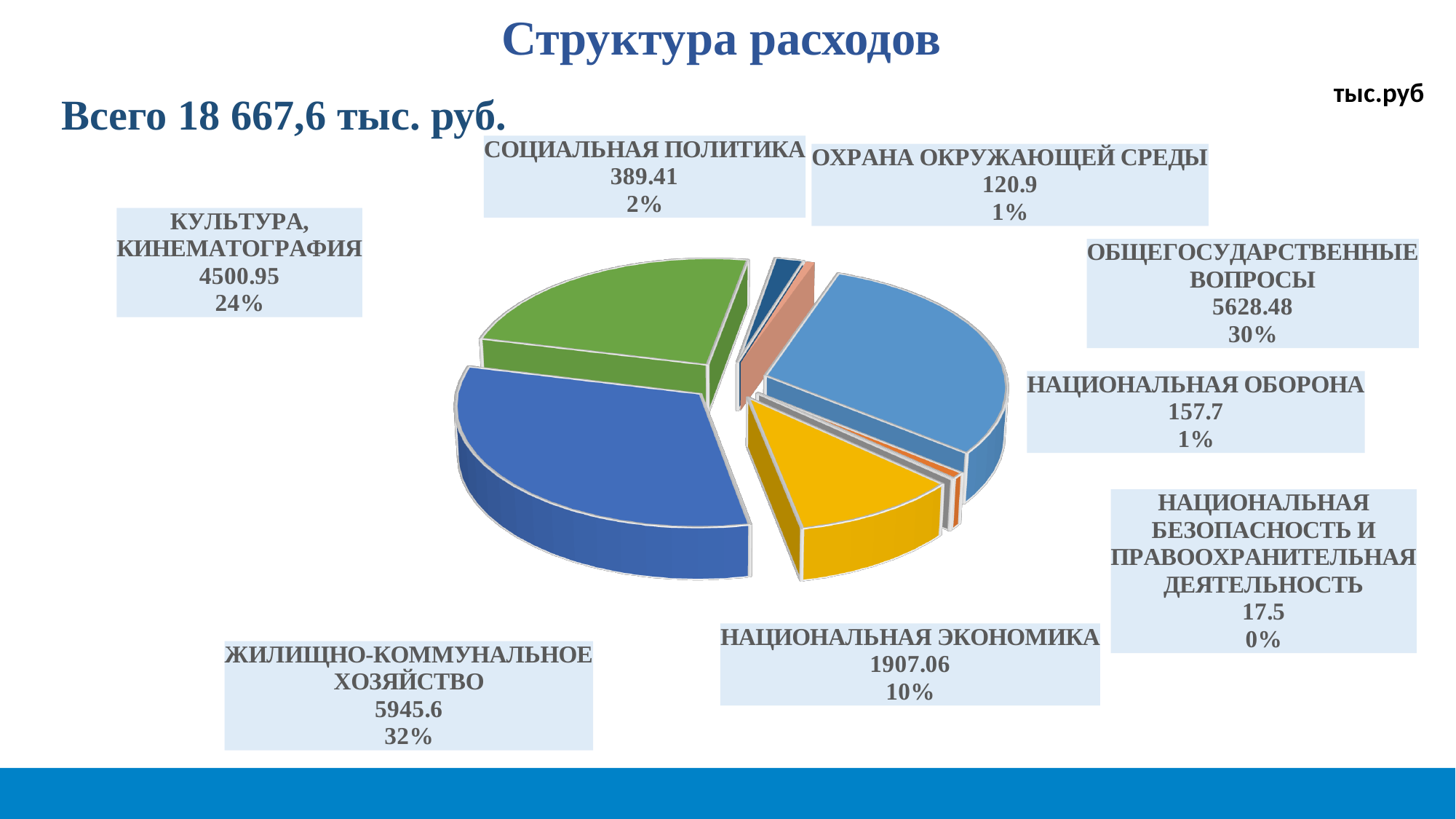
What is the value for НАЦИОНАЛЬНАЯ ЭКОНОМИКА? 1907.06 Which category has the largest value? ЖИЛИЩНО-КОММУНАЛЬНОЕ ХОЗЯЙСТВО What is the value for ЖИЛИЩНО-КОММУНАЛЬНОЕ ХОЗЯЙСТВО? 5945.6 What kind of chart is shown on the slide? pie chart What is the value for ОБЩЕГОСУДАРСТВЕННЫЕ ВОПРОСЫ? 5628.48 What share of the pie does КУЛЬТУРА, КИНЕМАТОГРАФИЯ represent? 24% Which category has the smallest value? НАЦИОНАЛЬНАЯ БЕЗОПАСНОСТЬ И ПРАВООХРАНИТЕЛЬНАЯ ДЕЯТЕЛЬНОСТЬ What is the difference between the values for ЖИЛИЩНО-КОММУНАЛЬНОЕ ХОЗЯЙСТВО and ОБЩЕГОСУДАРСТВЕННЫЕ ВОПРОСЫ? 317.12 What is the title of the chart? Структура расходов Which is larger, the value for КУЛЬТУРА, КИНЕМАТОГРАФИЯ or the value for НАЦИОНАЛЬНАЯ ЭКОНОМИКА? КУЛЬТУРА, КИНЕМАТОГРАФИЯ What is the value for ОХРАНА ОКРУЖАЮЩЕЙ СРЕДЫ? 120.9 How many categories does the pie chart show? 8